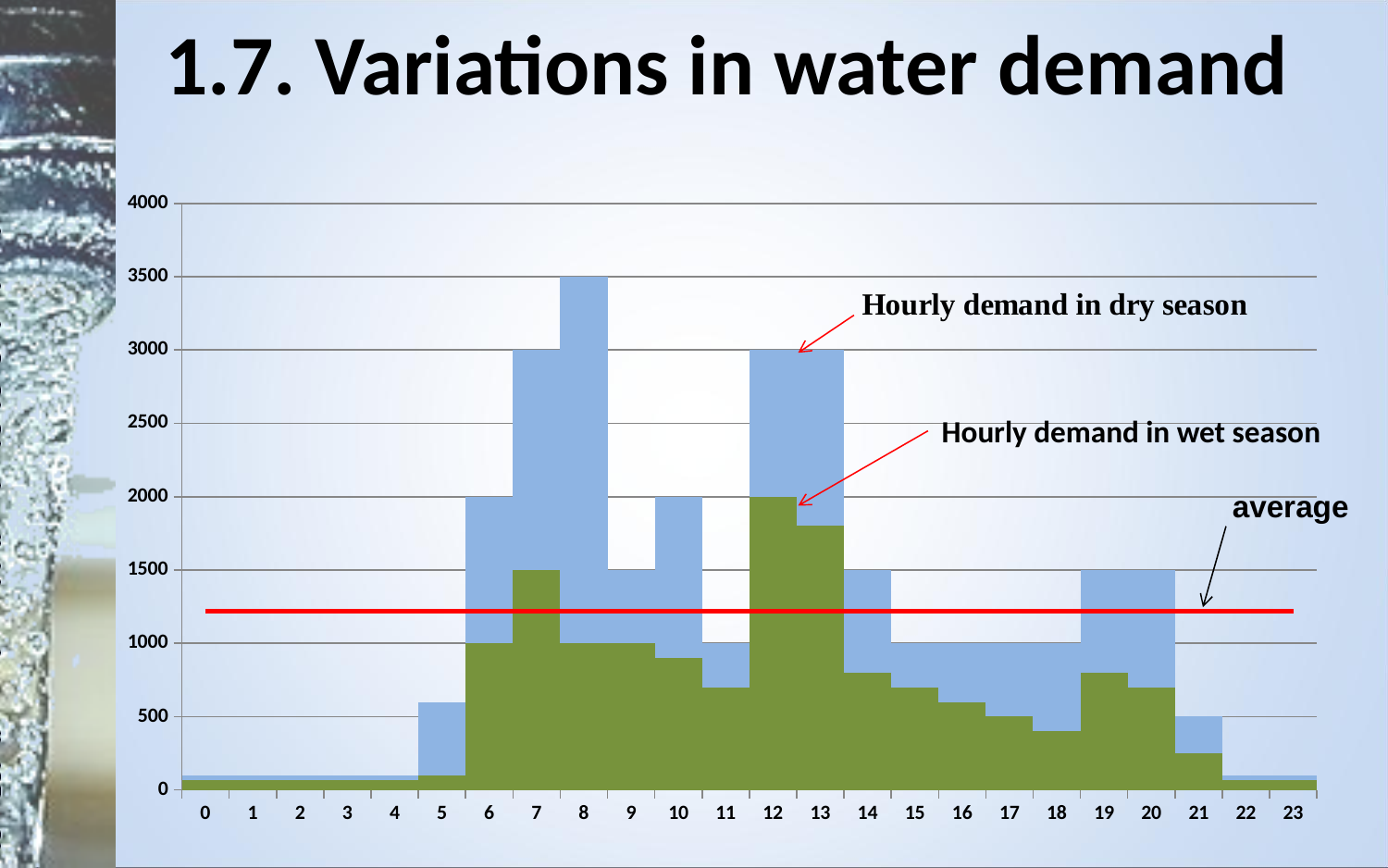
What is the hourly demand in dry season at hour 8? 3500 At which hour is the hourly demand in dry season highest? 8 What does the red horizontal line on the chart represent? average What is the hourly demand in wet season at hour 12? 2000 What is the hourly demand in dry season at hour 7? 3000 At which hour is the hourly demand in wet season highest? 12 Is the hourly demand in dry season at hour 5 greater or less than 1000? less What kind of chart is shown on the slide? bar chart Which is larger, the hourly demand in dry season at hour 8 or at hour 12? hour 8 Is the hourly demand in wet season at hour 13 greater or less than 1500? greater Does the hourly demand in dry season rise or fall from hour 13 to hour 18? fall How many hours are shown on the x axis? 24